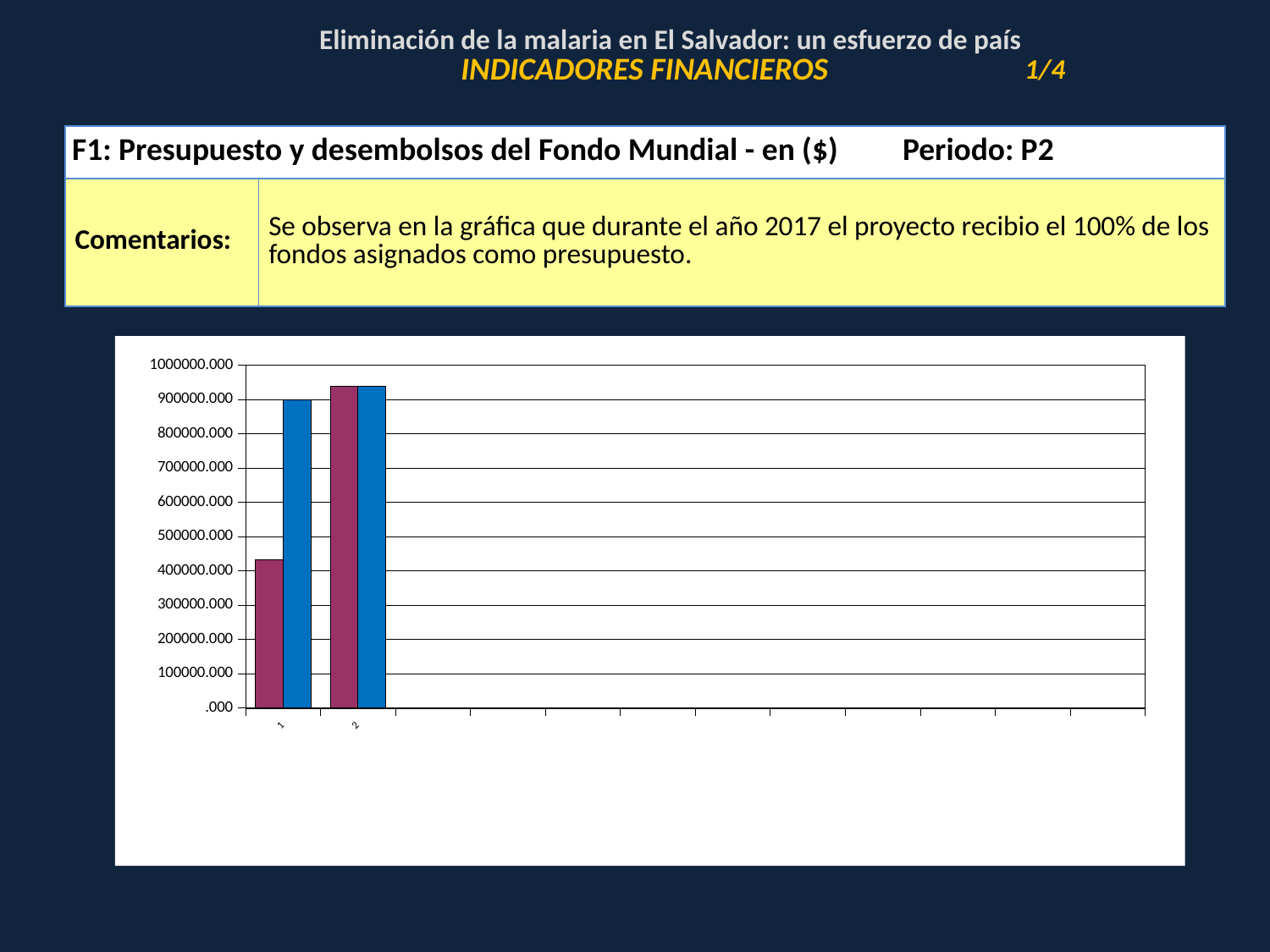
For category 1, which bar is larger, the purple bar or the blue bar? the blue bar What kind of chart is shown on the slide? bar chart Is the value of the purple bar for category 1 greater or less than 500000? less Which bar in the chart has the lowest value? the purple bar for category 1 Is the value of the blue bar for category 1 greater or less than 800000? greater Is the value of the purple bar for category 1 greater or less than 400000? greater How many categories are shown on the x axis of the chart? 2 Do the values of the purple bars rise or fall from category 1 to category 2? rise How many bars are plotted for each category in the chart? 2 What is the highest value shown on the vertical axis of the chart? 1000000.000